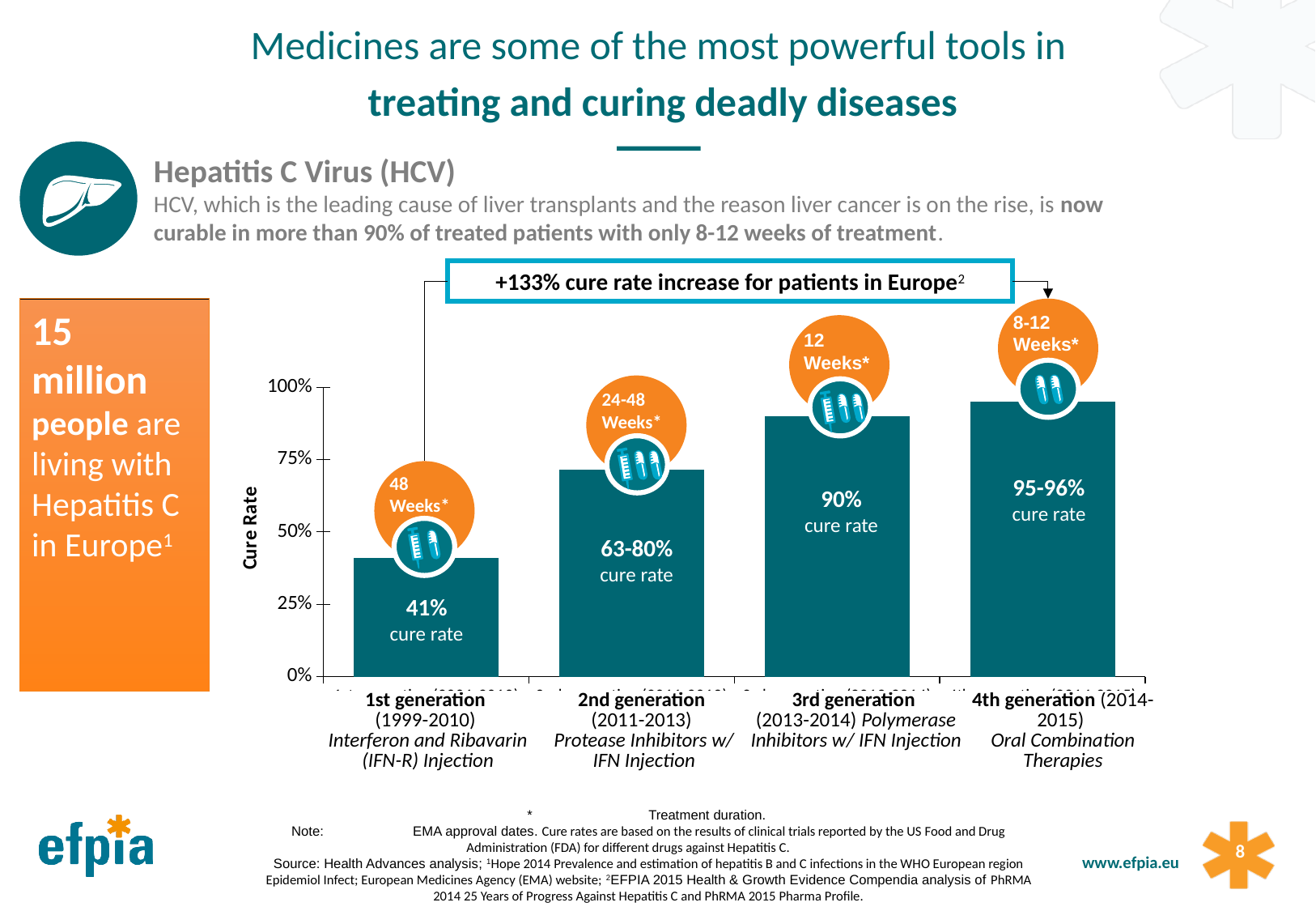
What is the difference in cure rate between the 3rd generation (90%) and the 1st generation (41%)? 49 percentage points Which generation of treatment has the lowest cure rate? 1st generation Is the cure rate for the 1st generation treatment greater or less than 50%? less Which has a higher cure rate, the 1st generation or the 3rd generation treatment? 3rd generation What cure rate is labelled on the 4th generation (Oral Combination Therapies) bar? 95-96% What type of chart is used to show the cure rates? Bar chart What is the cure rate shown for the 1st generation treatment? 41% How many treatment generations are shown as bars in the chart? 4 Which generation of treatment has the highest cure rate? 4th generation Do the cure rates rise or fall from the 1st generation to the 4th generation? Rise What cure rate range is labelled on the 2nd generation bar? 63-80% What cure rate is labelled on the 3rd generation bar? 90%